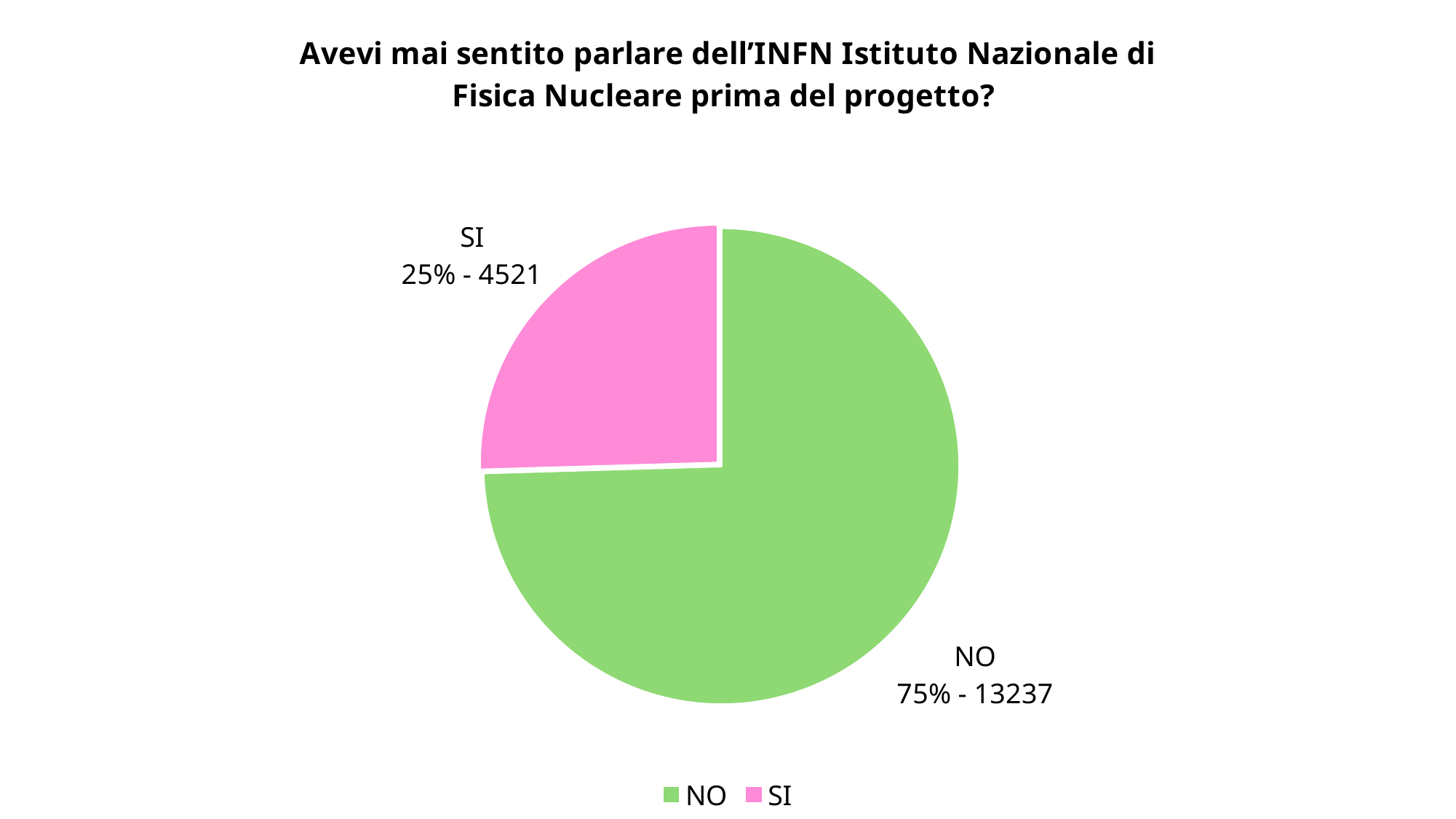
Which slice is the largest? NO Which is larger, the NO slice or the SI slice? NO What is the count shown for the SI slice? 4521 How many slices does the pie chart have? 2 What is the difference between the NO count and the SI count? 8716 What is the count shown for the NO slice? 13237 How many entries does the legend list? 2 What colour is the SI slice? pink Which slice is the smallest? SI What percentage of the pie does the NO slice represent? 75% What percentage of the pie does the SI slice represent? 25% What kind of chart is shown on the slide? pie chart